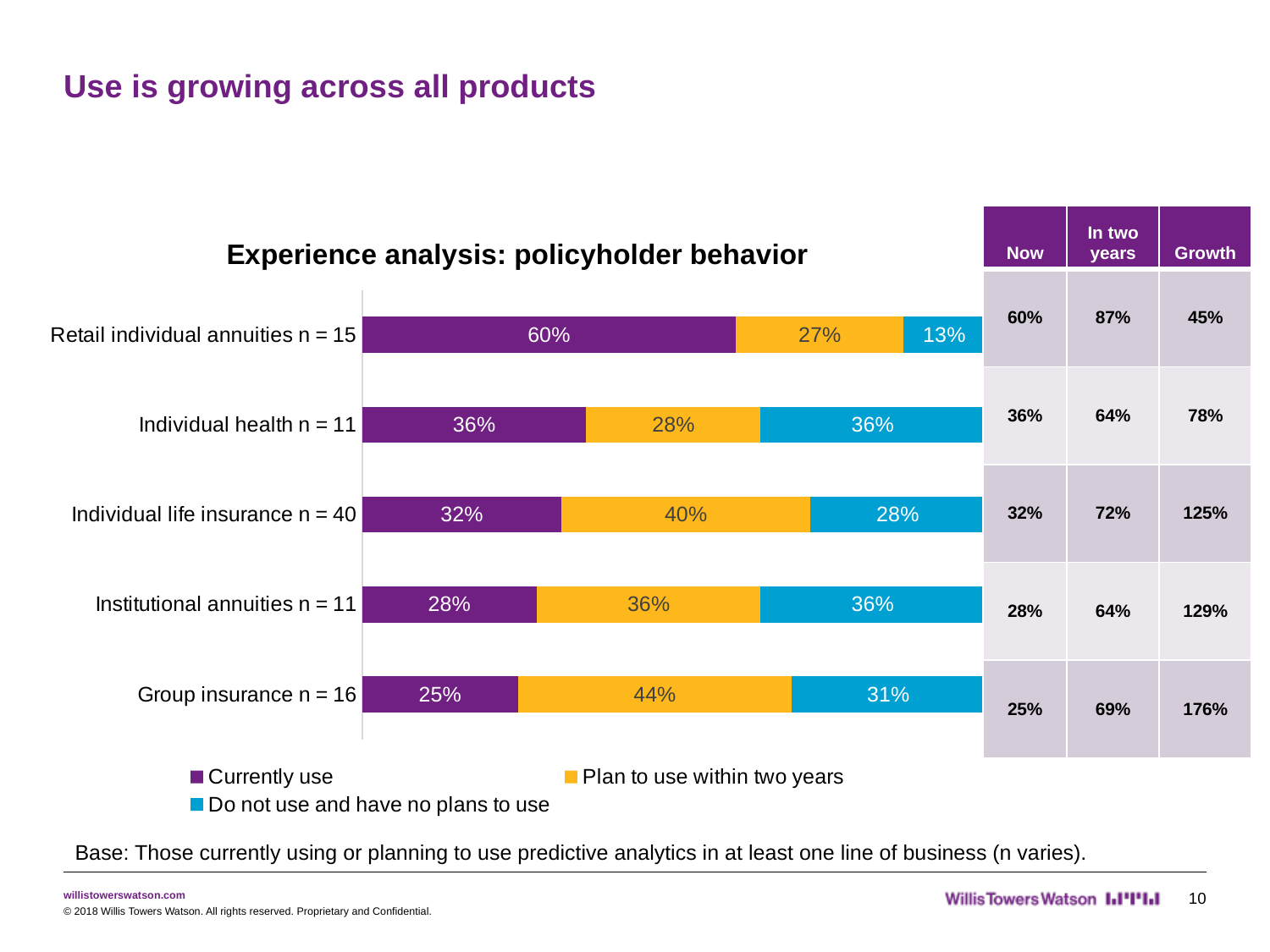
What is the total of the 'Currently use' and 'Plan to use within two years' segments for Institutional annuities? 64% What percentage of Retail individual annuities respondents currently use experience analysis for policyholder behavior? 60% Which is larger: the 'Plan to use within two years' value for Individual life insurance or for Individual health? Individual life insurance What type of chart is shown? Stacked bar chart Which product has the lowest 'Currently use' percentage? Group insurance How many series does the legend list? 3 What is the difference between the 'Currently use' values for Retail individual annuities and Individual health? 24% How many product categories are shown in the chart? 5 What is the title of the chart? Experience analysis: policyholder behavior Which product has the highest 'Currently use' percentage? Retail individual annuities What is the 'Do not use and have no plans to use' value for Individual life insurance? 28% What is the 'Plan to use within two years' value for Group insurance? 44%